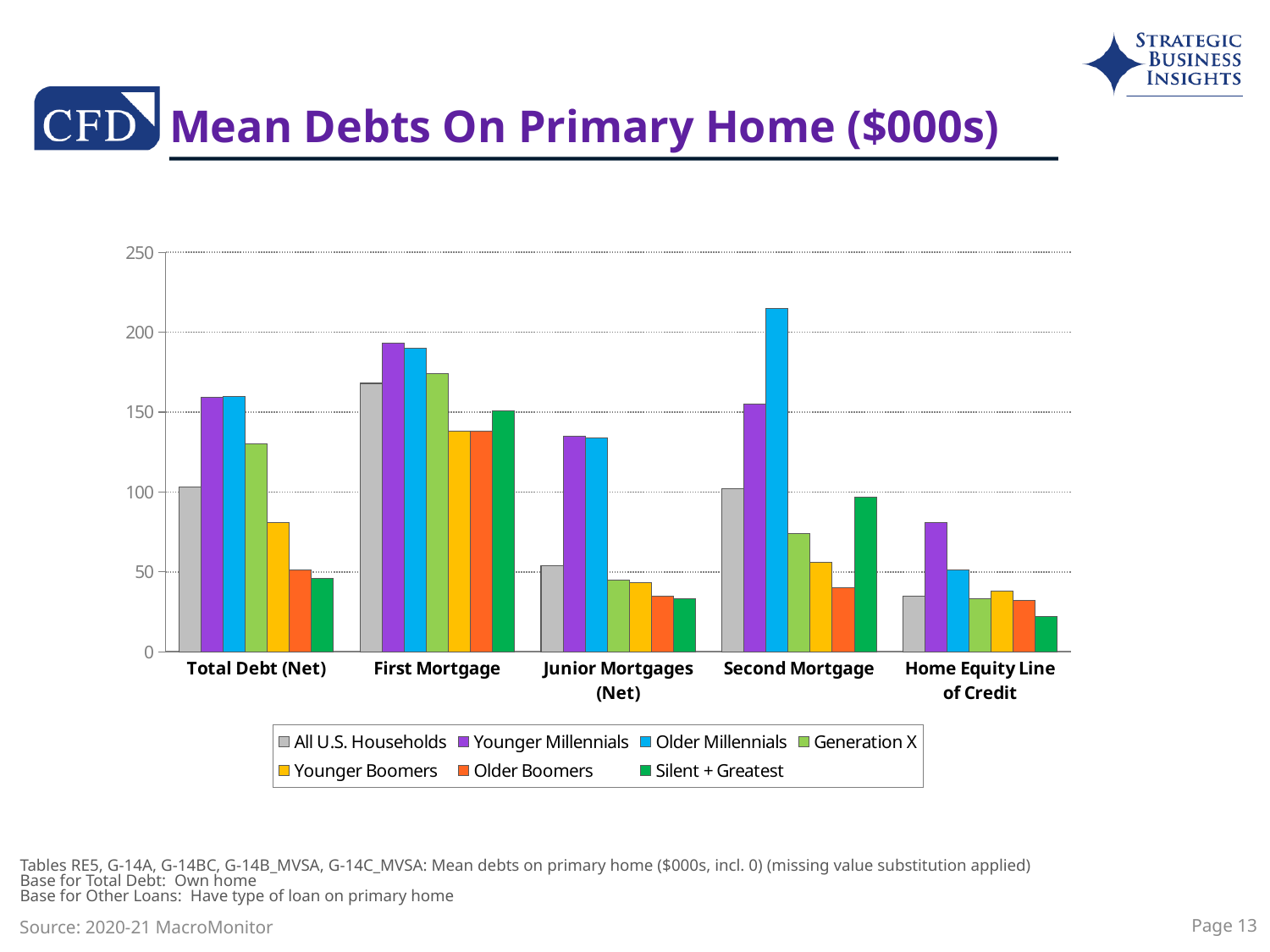
Is the First Mortgage value for Younger Millennials greater or less than 150? greater How many debt categories are shown along the x axis? 5 For Home Equity Line of Credit, which is larger: Younger Millennials or Older Millennials? Younger Millennials Is the Second Mortgage value for Generation X greater or less than 100? less How many series does the legend list? 7 Which group has the highest mean Second Mortgage debt? Older Millennials What kind of chart is shown on the slide? Bar chart Is the Junior Mortgages (Net) value for Silent + Greatest greater or less than 50? less Which group has the lowest mean Home Equity Line of Credit debt? Silent + Greatest For Total Debt (Net), which is larger: Generation X or Younger Boomers? Generation X Which group has the highest mean Home Equity Line of Credit debt? Younger Millennials